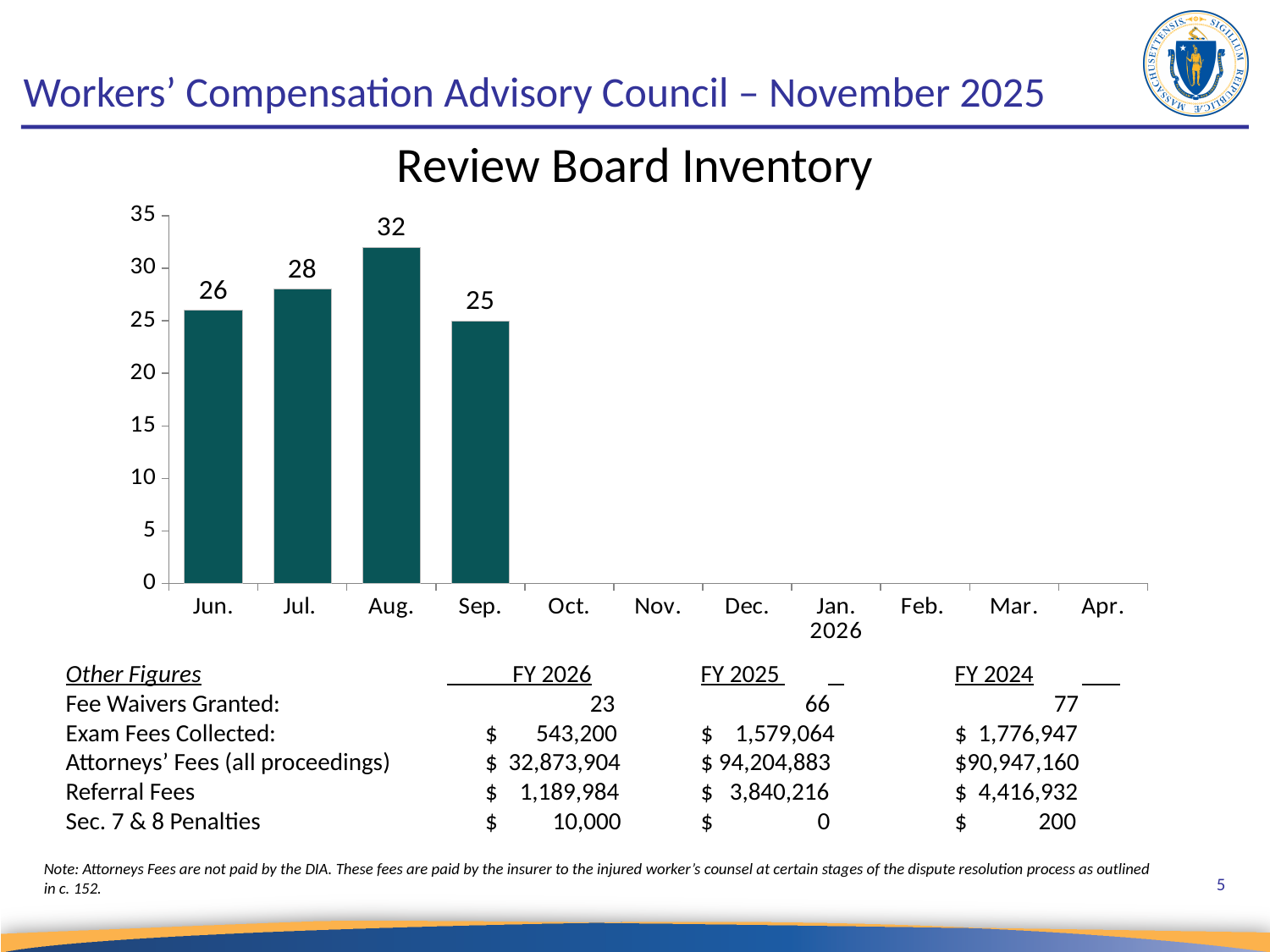
Is the Review Board Inventory value for Aug. greater or less than 30? greater What is the difference between the Review Board Inventory values for Jul. and Jun.? 2 Which is larger, the Review Board Inventory value for Jul. or for Sep.? Jul. What is the Review Board Inventory value for Aug.? 32 What is the difference between the Review Board Inventory values for Aug. and Sep.? 7 What is the Review Board Inventory value for Sep.? 25 What is the Review Board Inventory value for Jun.? 26 What kind of chart is the Review Board Inventory chart? bar chart Which month has the highest Review Board Inventory value? Aug. How many months have bars plotted in the Review Board Inventory chart? 4 What is the title of the chart on the slide? Review Board Inventory Among the months with plotted bars, which has the lowest Review Board Inventory value? Sep.